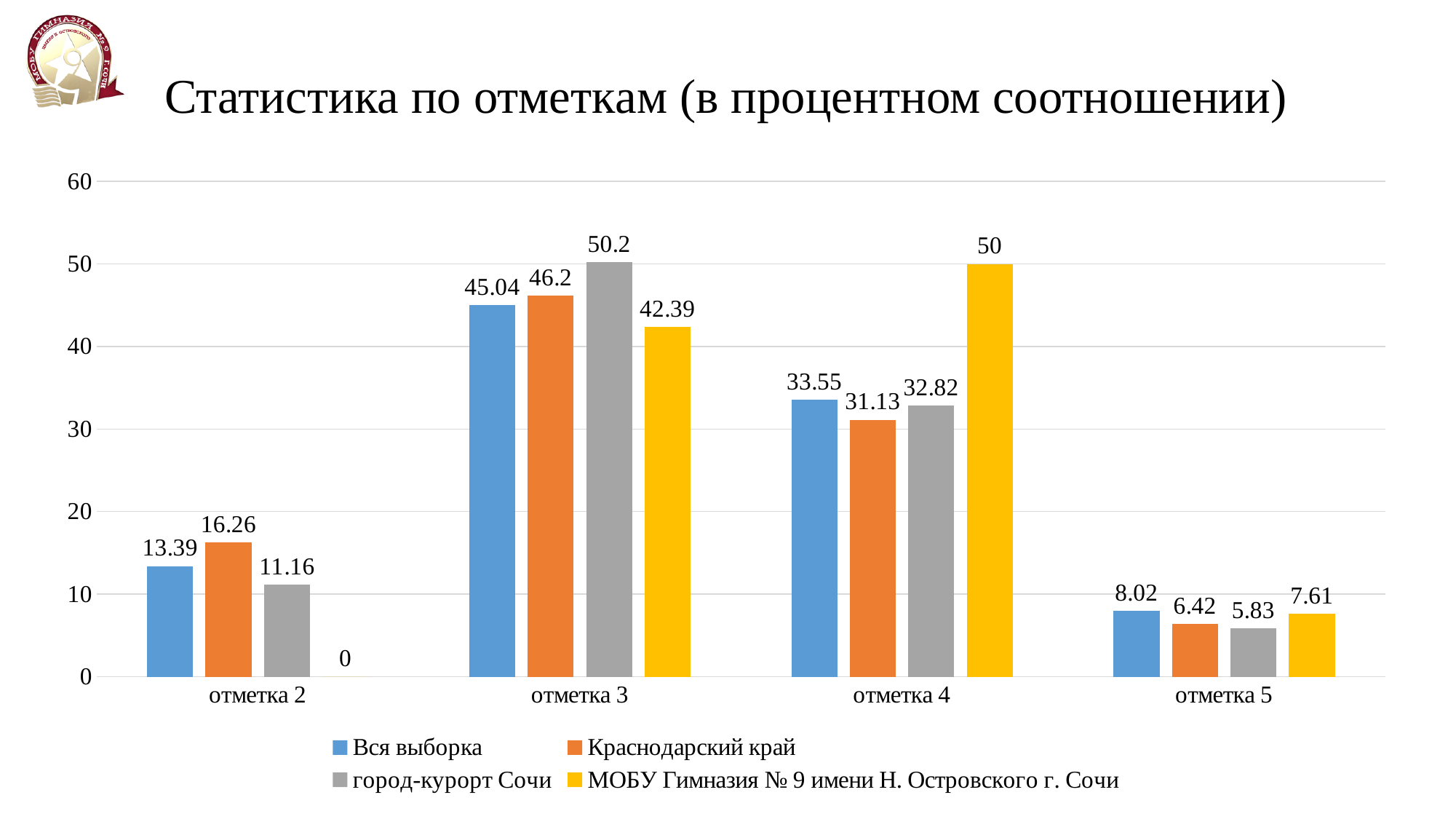
How many categories are shown on the x axis? 4 Which series has the highest value at отметка 3? город-курорт Сочи What is the value for Краснодарский край at отметка 5? 6.42 What is the value for Вся выборка at отметка 3? 45.04 What is the difference between Краснодарский край and Вся выборка at отметка 2? 2.87 What is the value for город-курорт Сочи at отметка 2? 11.16 Which is larger at отметка 4: Вся выборка or Краснодарский край? Вся выборка Which series has the lowest value at отметка 2? МОБУ Гимназия № 9 имени Н. Островского г. Сочи How many series does the legend list? 4 What kind of chart is shown on the slide? bar chart What is the value for МОБУ Гимназия № 9 имени Н. Островского г. Сочи at отметка 4? 50 What is the title of the chart on the slide? Статистика по отметкам (в процентном соотношении)